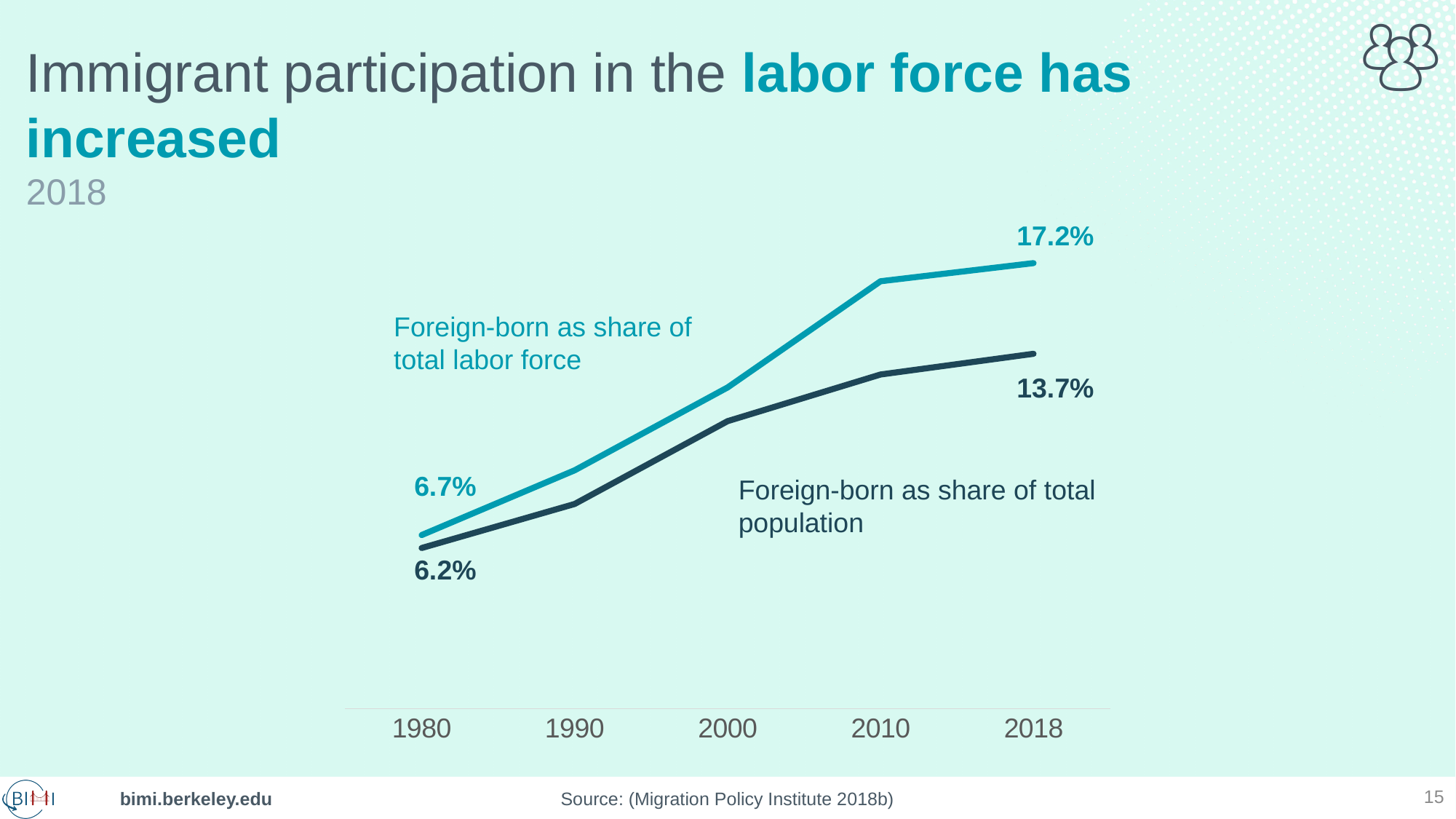
What type of chart is shown on the slide? Line chart By how many percentage points did the foreign-born share of the total population increase from 1980 to 2018? 7.5 percentage points In 2018, which is larger: the foreign-born share of the total labor force or the foreign-born share of the total population? Foreign-born as share of total labor force In 2018, what is the difference between the foreign-born share of the labor force and the foreign-born share of the total population? 3.5 percentage points Does the 'Foreign-born as share of total labor force' line rise or fall from 1980 to 2018? Rise What is the value of the 'Foreign-born as share of total population' line in 2018? 13.7% What is the value of the 'Foreign-born as share of total labor force' line in 2018? 17.2% By how many percentage points did the foreign-born share of the total labor force increase from 1980 to 2018? 10.5 percentage points What is the value of the 'Foreign-born as share of total population' line in 1980? 6.2% How many data series are plotted on the chart? 2 What is the value of the 'Foreign-born as share of total labor force' line in 1980? 6.7% How many years are shown on the x axis of the chart? 5